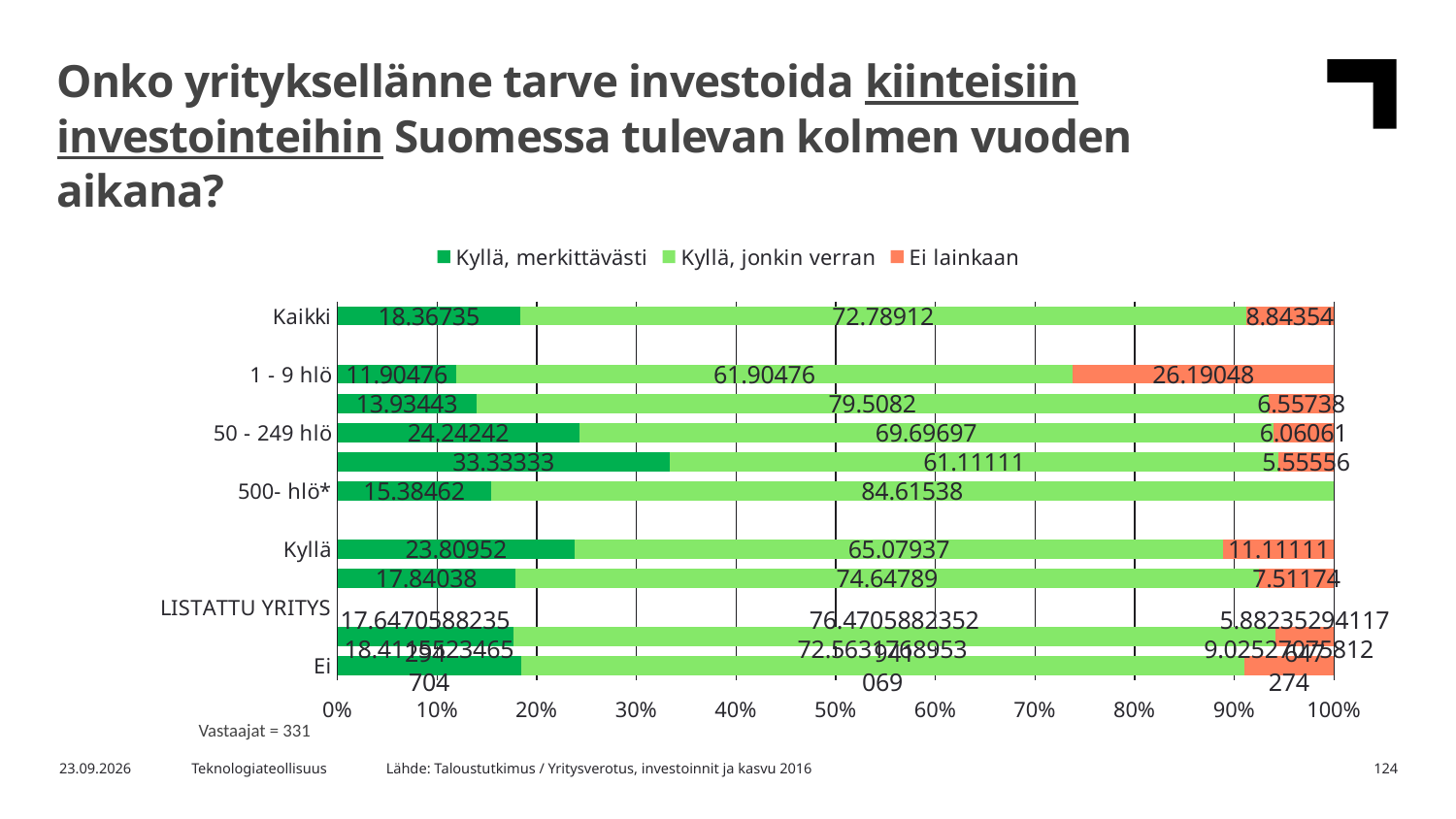
Which is larger, the "Kyllä, merkittävästi" value for Kaikki or for 1 - 9 hlö? Kaikki What is the value of "Ei lainkaan" for Kaikki? 8.84354 What is the value of "Kyllä, jonkin verran" for 500- hlö*? 84.61538 How many series does the legend list? 3 What type of chart is shown on the slide? stacked bar chart What is the value of "Ei lainkaan" for 1 - 9 hlö? 26.19048 What is the value of "Kyllä, jonkin verran" for Kaikki? 72.78912 Which is larger, the "Ei lainkaan" value for 1 - 9 hlö or for Kyllä? 1 - 9 hlö What is the value of "Kyllä, merkittävästi" for 50 - 249 hlö? 24.24242 Which series is shown in orange in the legend? Ei lainkaan What is the value of "Ei lainkaan" for Kyllä? 11.11111 What is the value of "Kyllä, merkittävästi" for Kaikki? 18.36735